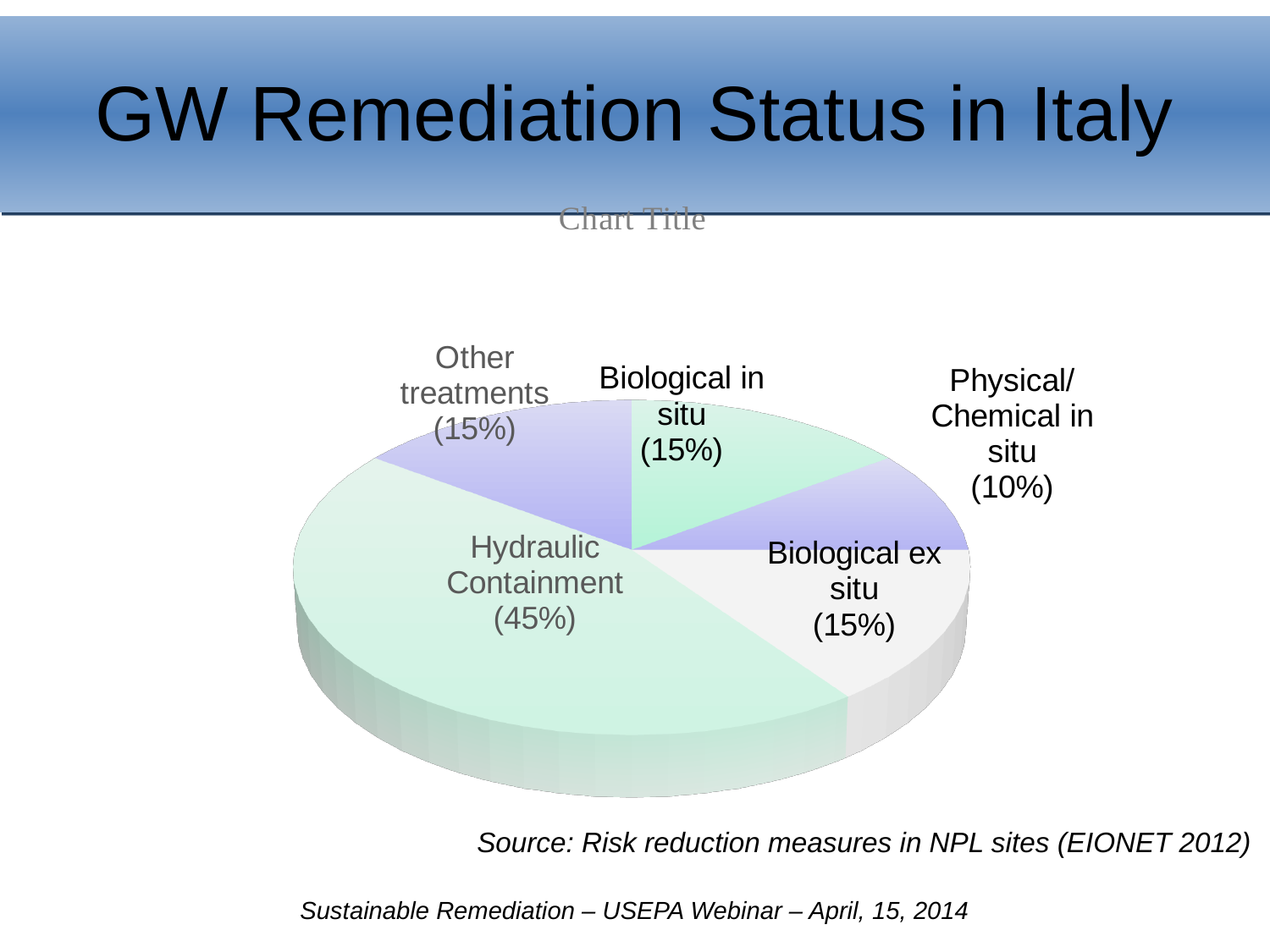
What share of the pie does Hydraulic Containment have? 45% What is the difference in percentage points between Hydraulic Containment and Biological in situ? 30 Which category has the smallest share of the pie? Physical/Chemical in situ What share of the pie does Physical/Chemical in situ have? 10% Which category has the largest share of the pie? Hydraulic Containment What is the source cited below the chart? Risk reduction measures in NPL sites (EIONET 2012) Which is larger, the share for Biological ex situ or the share for Physical/Chemical in situ? Biological ex situ What share of the pie does Other treatments have? 15% How many categories are shown in the pie chart? 5 What kind of chart is shown on the slide? pie chart What is the combined share of Biological in situ and Biological ex situ? 30%